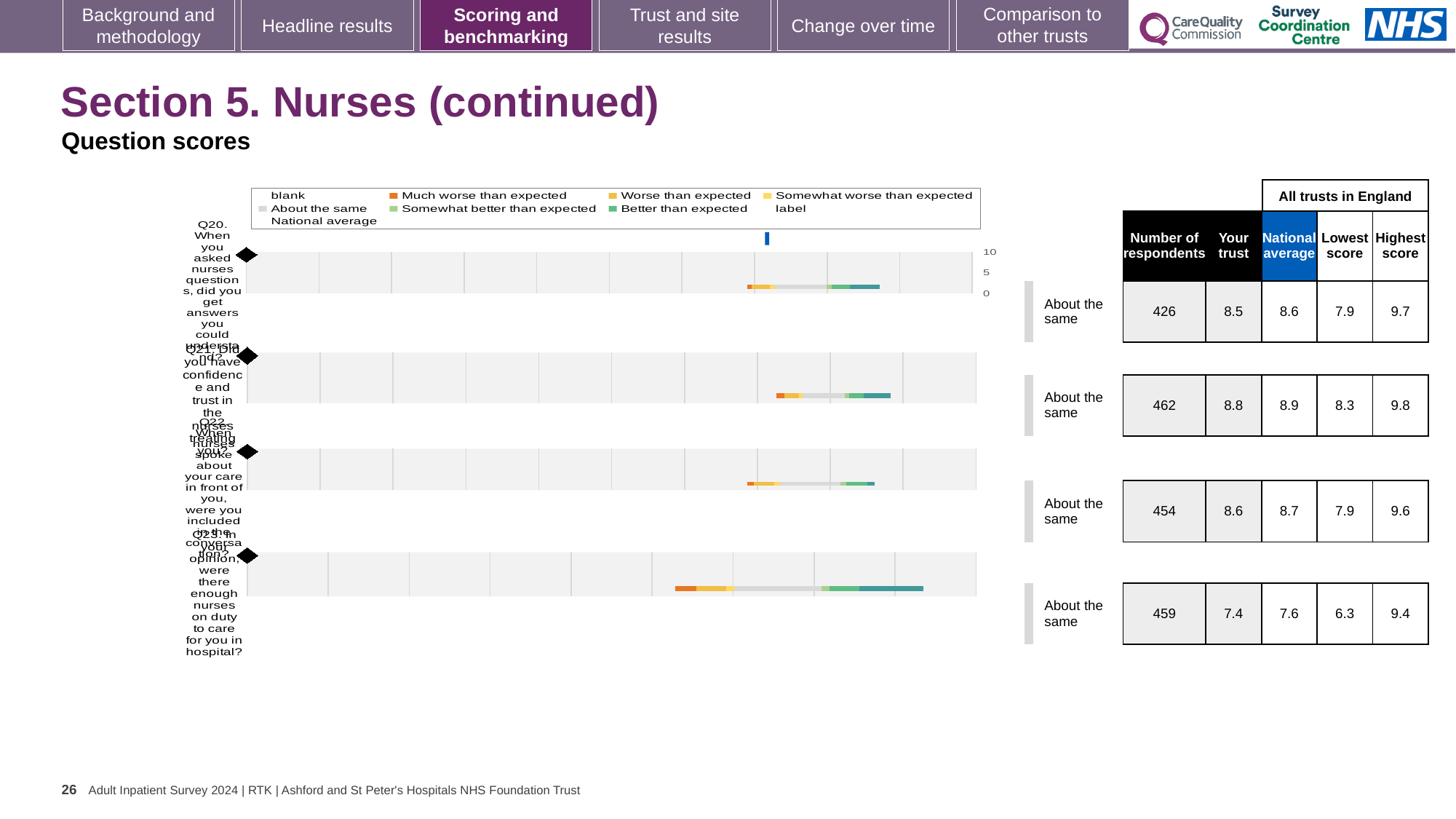
In the table beside the Q20 chart, what is the 'Your trust' score? 8.5 What is the highest tick value shown on the score axis of the Q20 chart? 10 Which question has the lowest 'Your trust' score in the tables? Q23 In the table beside the Q23 chart, what is the national average score? 7.6 What colour does the legend use for 'Much worse than expected'? orange How many question charts are shown on the slide? 4 For Q23, what is the difference between the highest score and the lowest score across all trusts in England? 3.1 What benchmark category is shown next to each of the four question charts? About the same For Q20, which is larger: the 'Your trust' score or the national average? National average What kind of chart is used to show the question scores for Q20 to Q23? bar chart Which question has the highest 'Your trust' score in the tables? Q21 In the table beside the Q21 chart, how many respondents are listed? 462